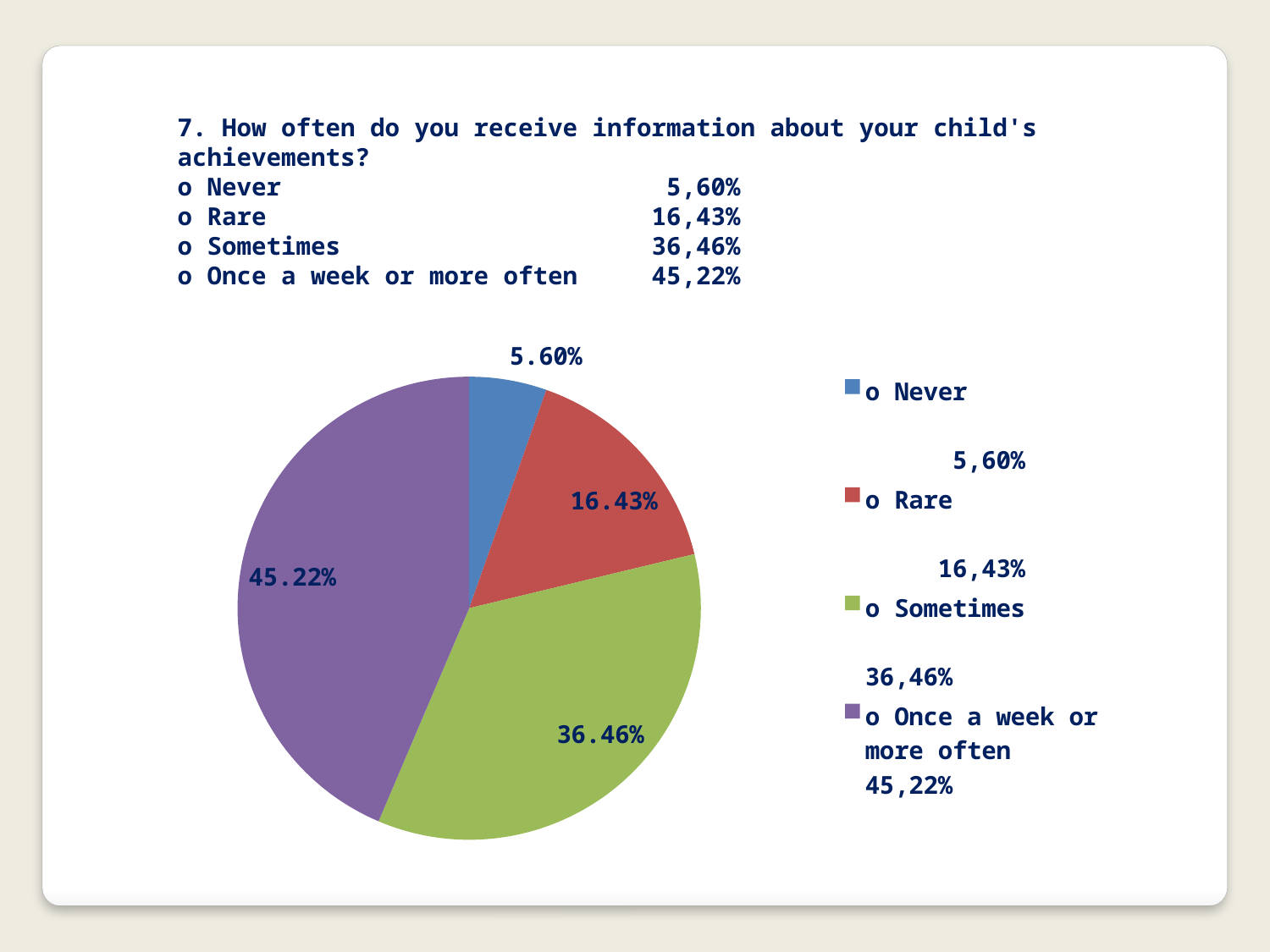
Which category has the largest slice of the pie? Once a week or more often Which category has the smallest slice of the pie? Never What is the difference between the "Once a week or more often" slice and the "Sometimes" slice? 8.76% Which is larger, the "Sometimes" slice or the "Rare" slice? Sometimes What colour is the "Sometimes" slice in the pie chart? green What is the value shown for the "Rare" slice? 16.43% What is the value shown for the "Once a week or more often" slice? 45.22% What share of the pie does the "Never" slice represent? 5.60% What is the difference between the "Rare" slice and the "Never" slice? 10.83% What kind of chart is shown on the slide? pie chart How many slices does the pie chart have? 4 What is the value shown for the "Sometimes" slice? 36.46%